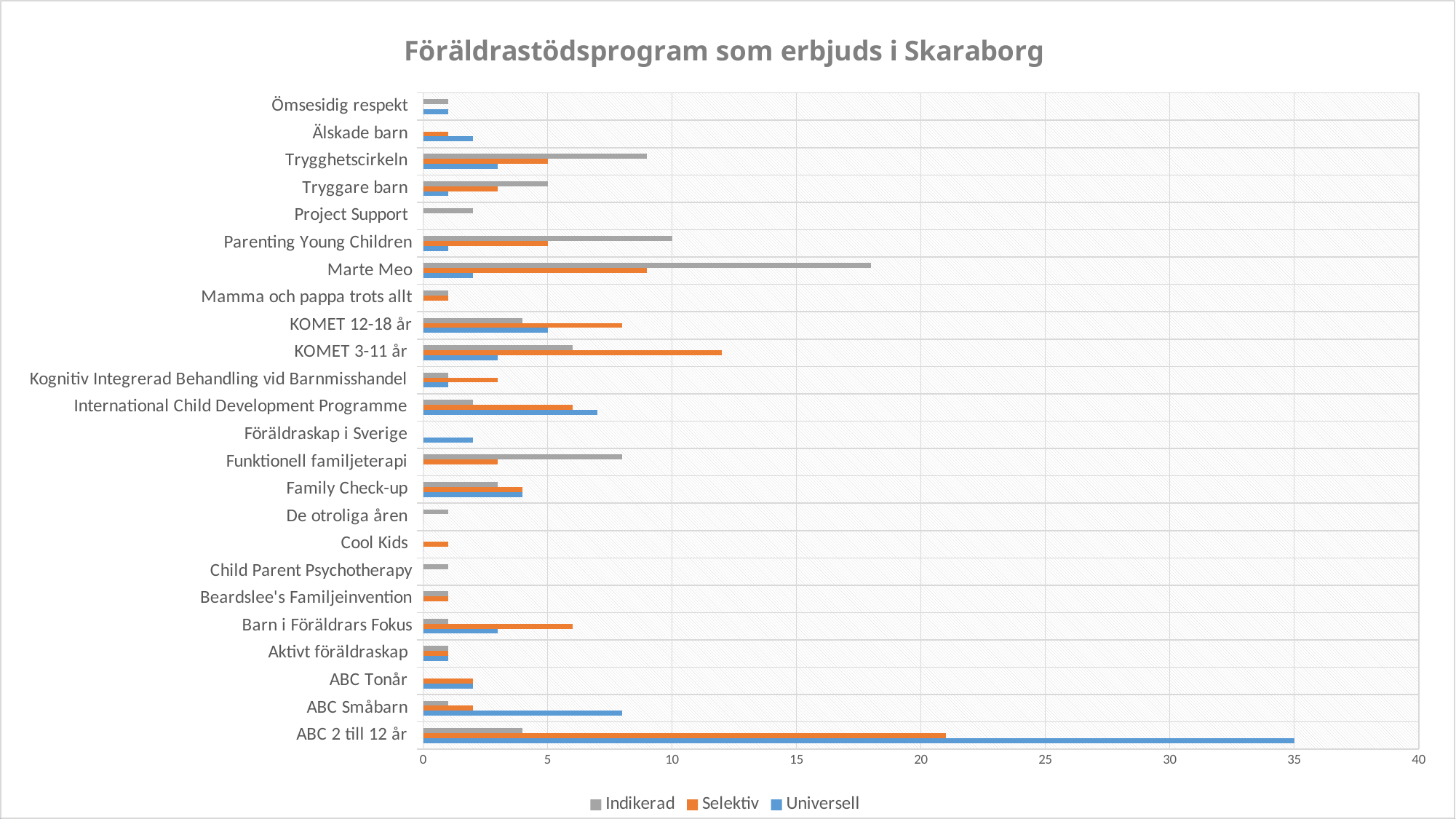
Which has the larger Selektiv value, KOMET 3-11 år or KOMET 12-18 år? KOMET 3-11 år Is the Selektiv value for ABC 2 till 12 år greater or less than 20? greater Which program has the highest Universell value? ABC 2 till 12 år What is the Indikerad value for Parenting Young Children? 10 How many series does the legend list? 3 How many programs (categories) are listed on the vertical axis? 24 Which program has the highest Selektiv value? ABC 2 till 12 år What is the title of the chart? Föräldrastödsprogram som erbjuds i Skaraborg What is the Universell value for ABC 2 till 12 år? 35 What kind of chart is shown on the slide? bar chart Which program has the highest Indikerad value? Marte Meo Is the Indikerad value for Marte Meo greater or less than 15? greater